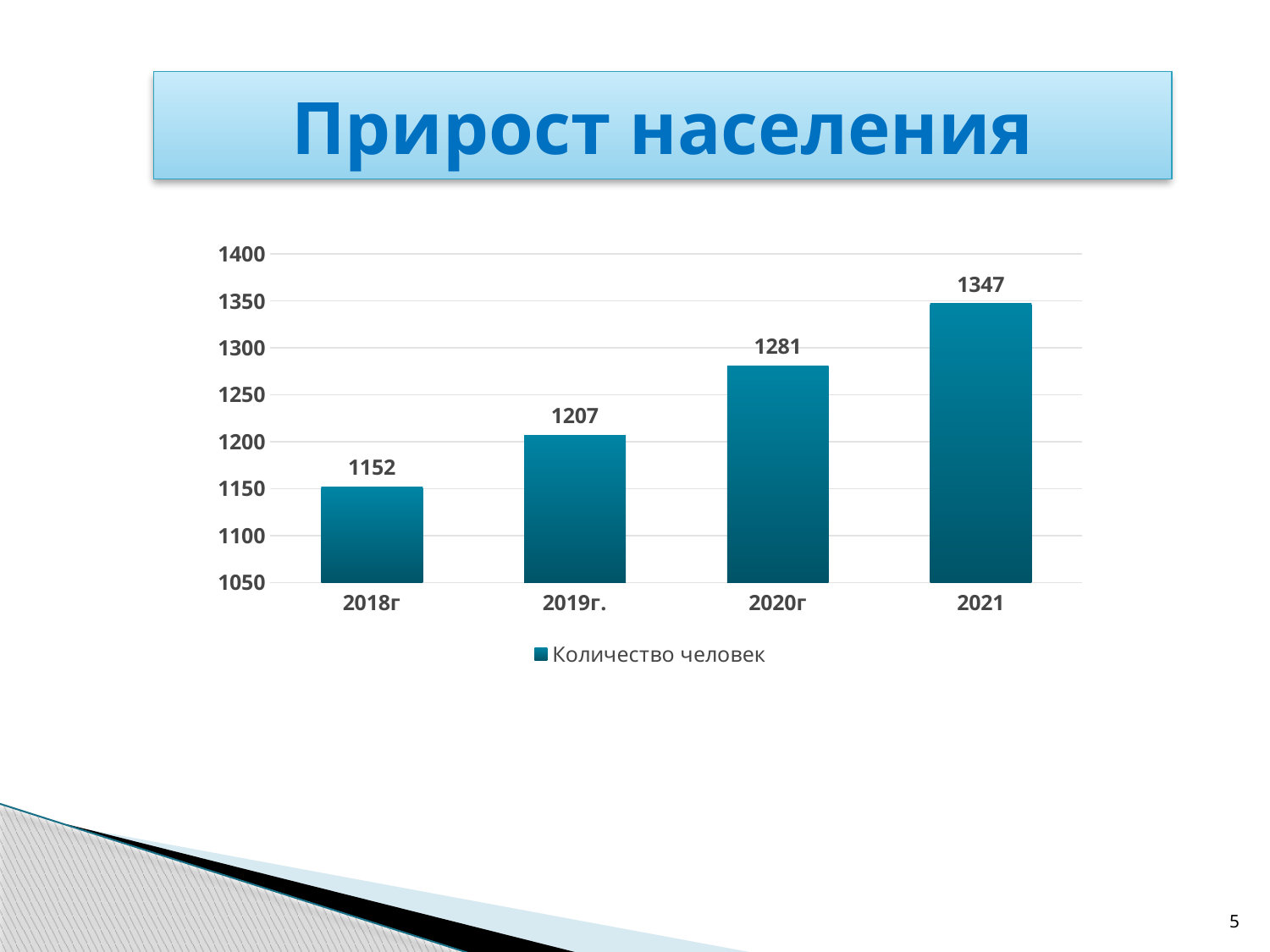
What is the difference between the values for 2020г and 2019г.? 74 Is the value for 2019г. greater or less than 1250? less Do the values rise or fall from 2018г to 2021? rise What is the value for 2021? 1347 What kind of chart is shown on the slide? bar chart What is the difference between the values for 2021 and 2018г? 195 How many years are shown on the x axis? 4 Which year has the lowest value? 2018г Which is larger, the value for 2019г. or the value for 2020г? 2020г What is the value for 2018г? 1152 What is the value for 2020г? 1281 Which year has the highest value? 2021